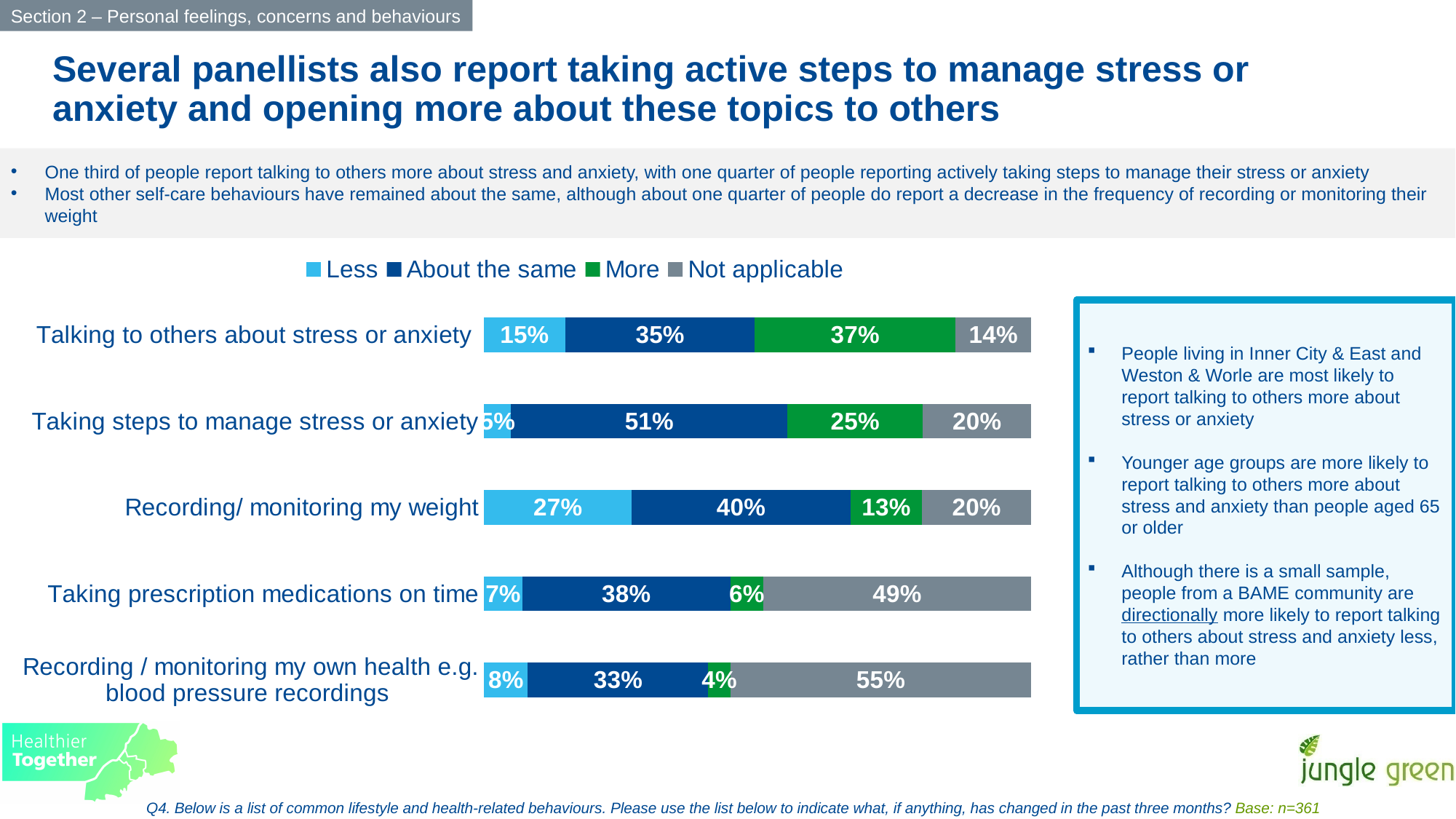
What percentage report doing 'Less' recording/ monitoring of their weight? 27% What is the 'Not applicable' value for 'Taking prescription medications on time'? 49% Which behaviour has the highest 'About the same' percentage? Taking steps to manage stress or anxiety Which behaviour has the highest 'Not applicable' percentage? Recording / monitoring my own health e.g. blood pressure recordings How many series does the legend list? 4 Which has a larger 'Less' percentage: 'Recording/ monitoring my weight' or 'Talking to others about stress or anxiety'? Recording/ monitoring my weight What percentage of panellists report talking to others about stress or anxiety 'More'? 37% What is the difference in 'Not applicable' percentages between 'Recording / monitoring my own health' and 'Taking prescription medications on time'? 6 percentage points How many behaviours are shown in the chart? 5 What is the difference between the 'More' percentage for 'Talking to others about stress or anxiety' and for 'Taking steps to manage stress or anxiety'? 12 percentage points What type of chart is shown on the slide? Stacked bar chart Which behaviour has the lowest 'More' percentage? Recording / monitoring my own health e.g. blood pressure recordings